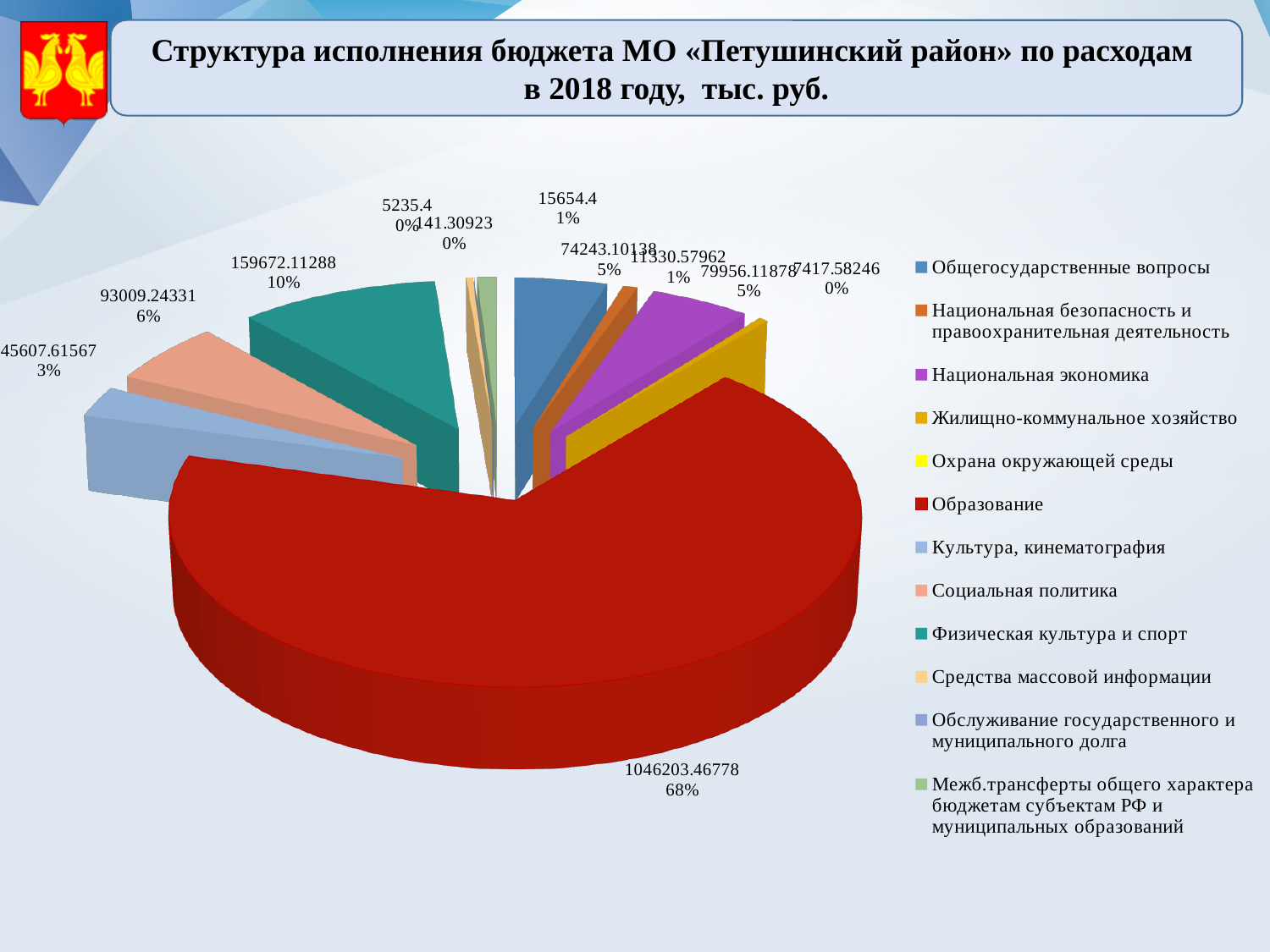
How many categories does the legend of the pie chart list? 12 What share of the pie does Социальная политика account for? 6% What is the value shown for Социальная политика? 93009.24331 What share of the pie does Физическая культура и спорт account for? 10% What is the difference between the values for Физическая культура и спорт and Социальная политика? 66662.86957 What share of the pie does Образование account for? 68% What is the value shown for Образование? 1046203.46778 What is the title of the chart on the slide? Структура исполнения бюджета МО «Петушинский район» по расходам в 2018 году, тыс. руб. Which is larger, the value for Физическая культура и спорт or the value for Социальная политика? Физическая культура и спорт What is the value shown for Физическая культура и спорт? 159672.11288 What kind of chart is shown on the slide? pie chart Which category has the largest slice of the pie? Образование